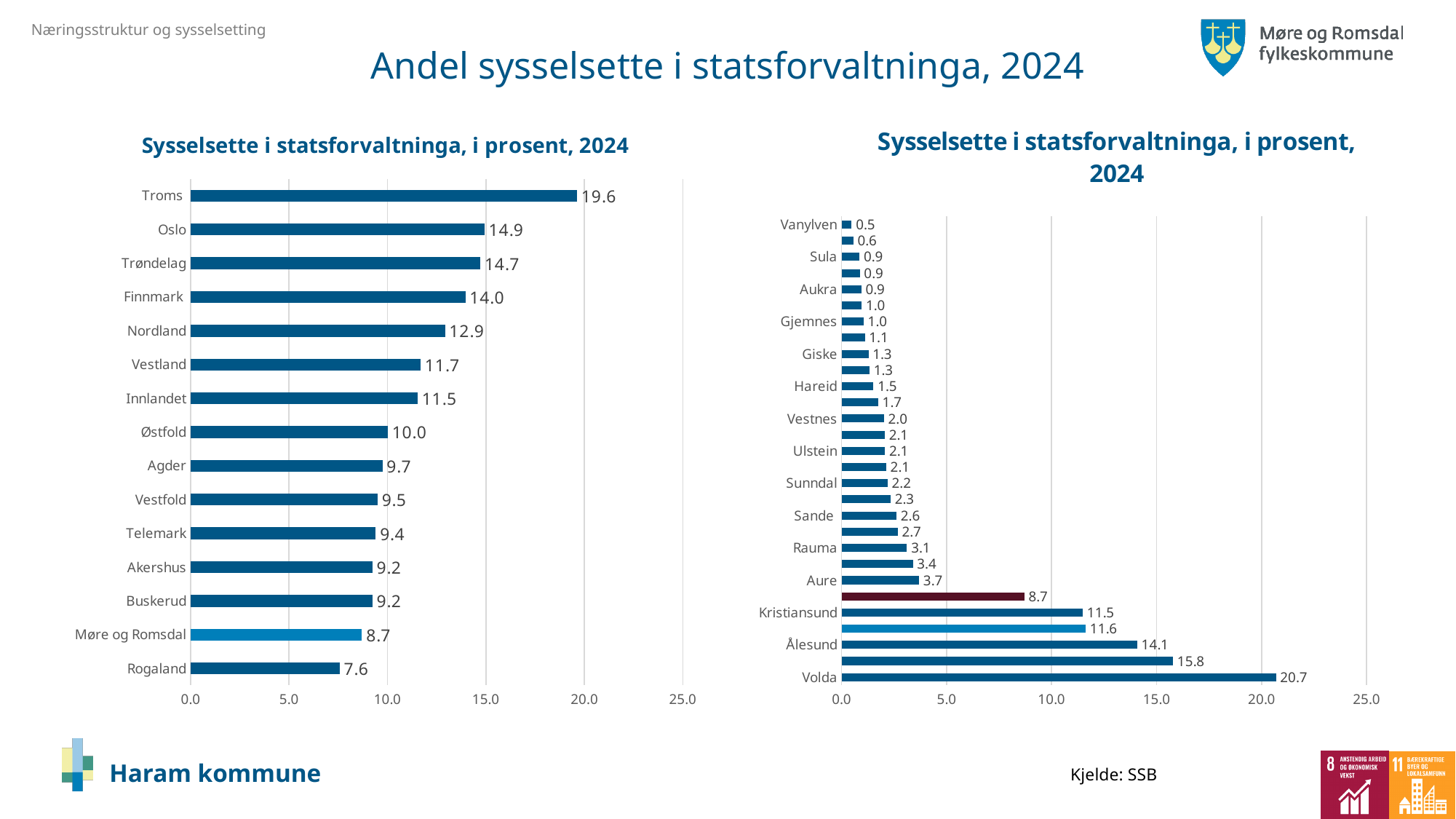
In the left chart, how many categories are plotted? 15 In the left chart, which category has the lowest value? Rogaland In the right chart, what is the difference between the values for Volda and Ålesund? 6.6 In the left chart, which category has the highest value? Troms In the right chart, what is the value for Volda? 20.7 In the left chart, what is the value for Troms? 19.6 In the right chart, which is larger, the value for Ålesund or the value for Kristiansund? Ålesund In the left chart, what is the value for Møre og Romsdal? 8.7 In the right chart, which labelled category has the highest value? Volda In the left chart, what is the difference between the values for Oslo and Rogaland? 7.3 What kind of chart is the left chart? Bar chart In the right chart, which labelled category has the lowest value? Vanylven